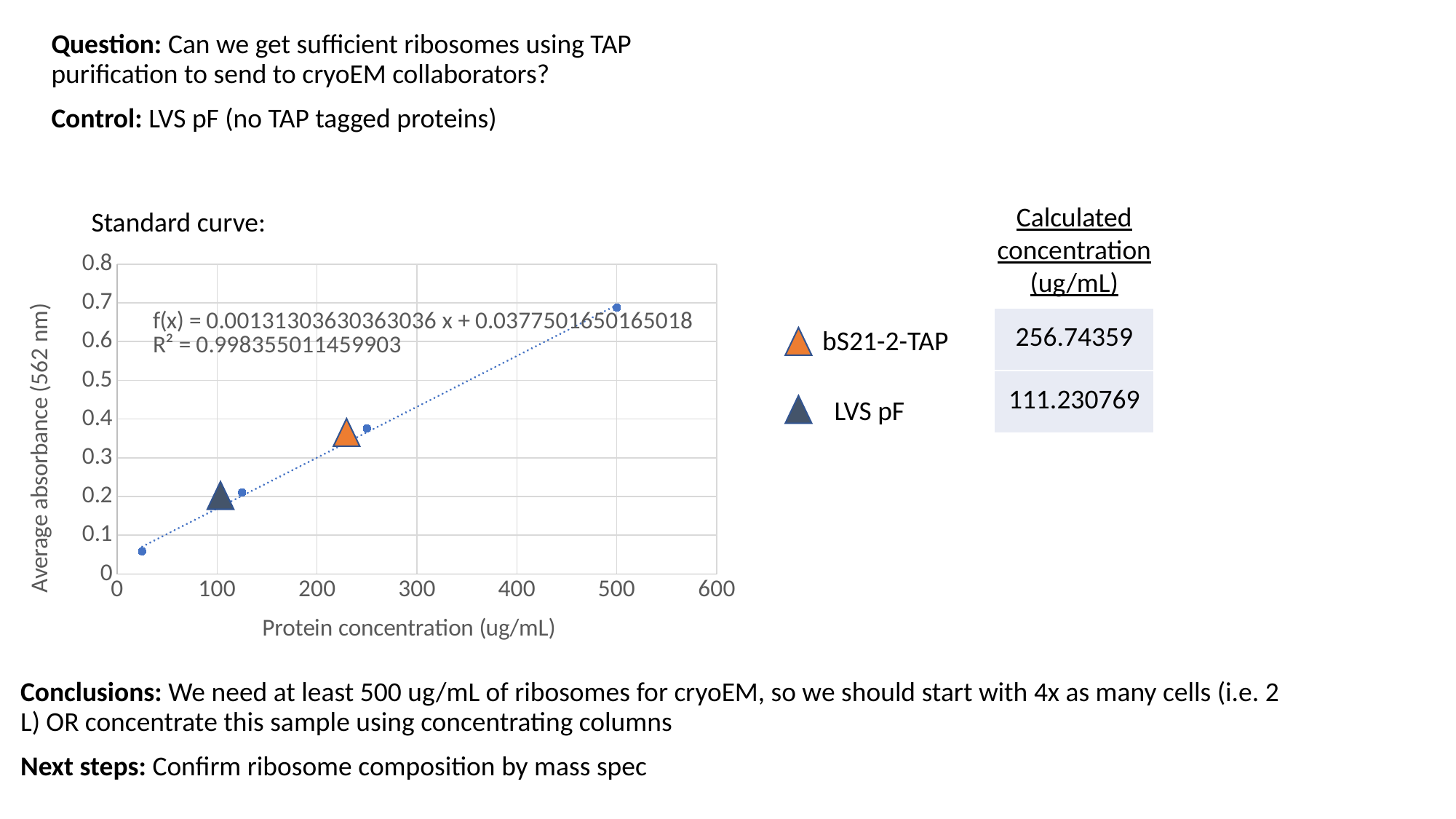
What kind of chart is shown on the slide? scatter chart Is the highest plotted standard-curve point above or below 0.6 absorbance? above Which sample has the higher calculated concentration, bS21-2-TAP or LVS pF? bS21-2-TAP What R² value is printed on the chart? 0.998355011459903 How many blue circular standard-curve data points are plotted on the chart? 4 Does average absorbance rise or fall as protein concentration increases along the x axis? rise What is the calculated concentration (ug/mL) shown for bS21-2-TAP? 256.74359 What is the label of the y axis of the chart? Average absorbance (562 nm) Is the absorbance of the LVS pF triangle greater or less than 0.3? less What is the title of the chart? Standard curve: Is the absorbance of the bS21-2-TAP triangle greater or less than 0.3? greater What is the calculated concentration (ug/mL) shown for LVS pF? 111.230769